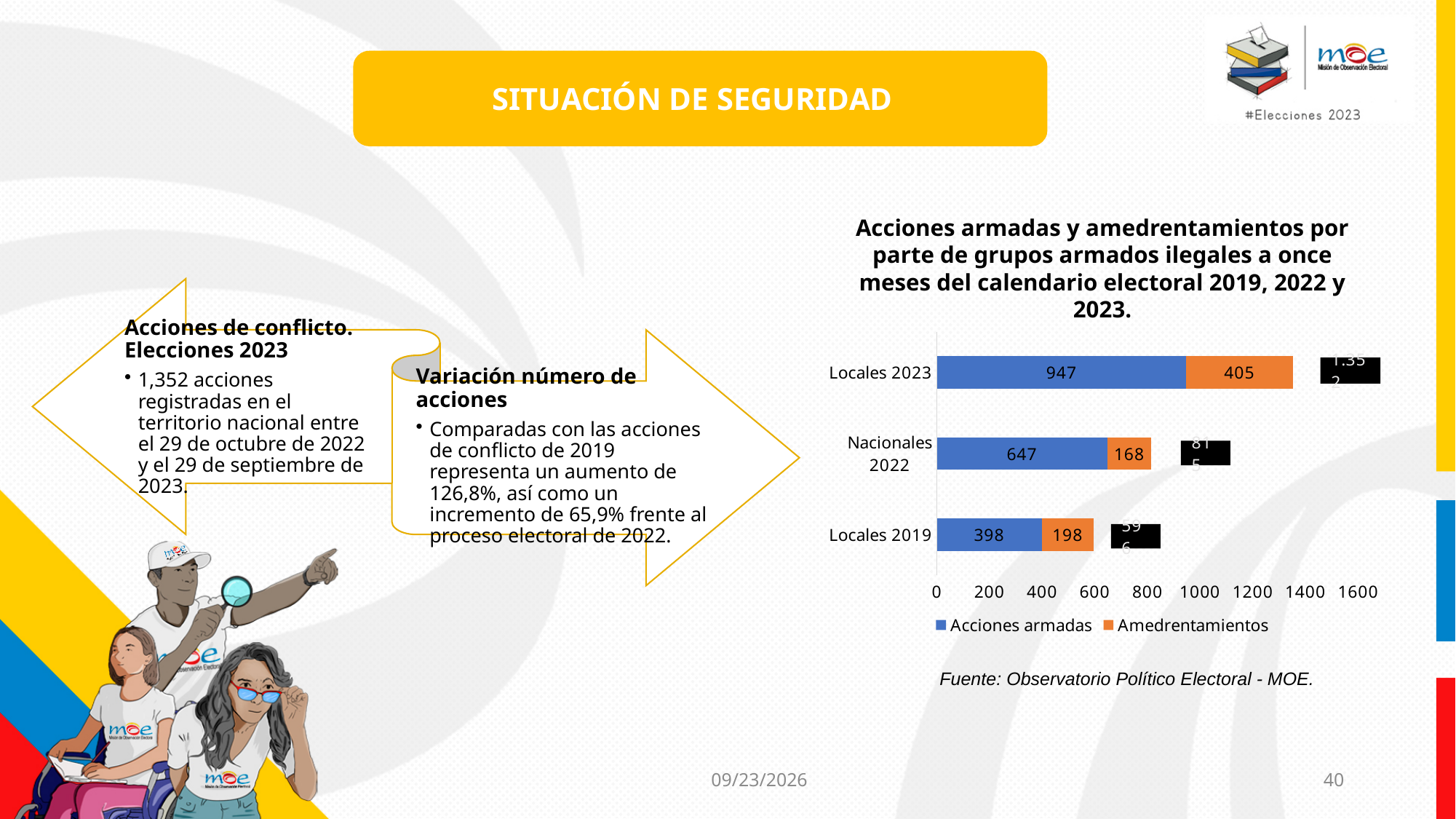
What is the value of Acciones armadas for Locales 2023? 947 What is the value of Amedrentamientos for Locales 2019? 198 How many series does the legend list? 2 What is the value of Acciones armadas for Locales 2019? 398 What is the difference between Acciones armadas for Locales 2023 and Nacionales 2022? 300 How many categories are shown on the chart? 3 Which is larger: Amedrentamientos for Locales 2023 or Amedrentamientos for Locales 2019? Locales 2023 What is the total of the stacked bar for Nacionales 2022? 815 What is the value of Amedrentamientos for Nacionales 2022? 168 Which category has the lowest value for Amedrentamientos? Nacionales 2022 What kind of chart is shown on the slide? Stacked bar chart Which category has the highest value for Acciones armadas? Locales 2023